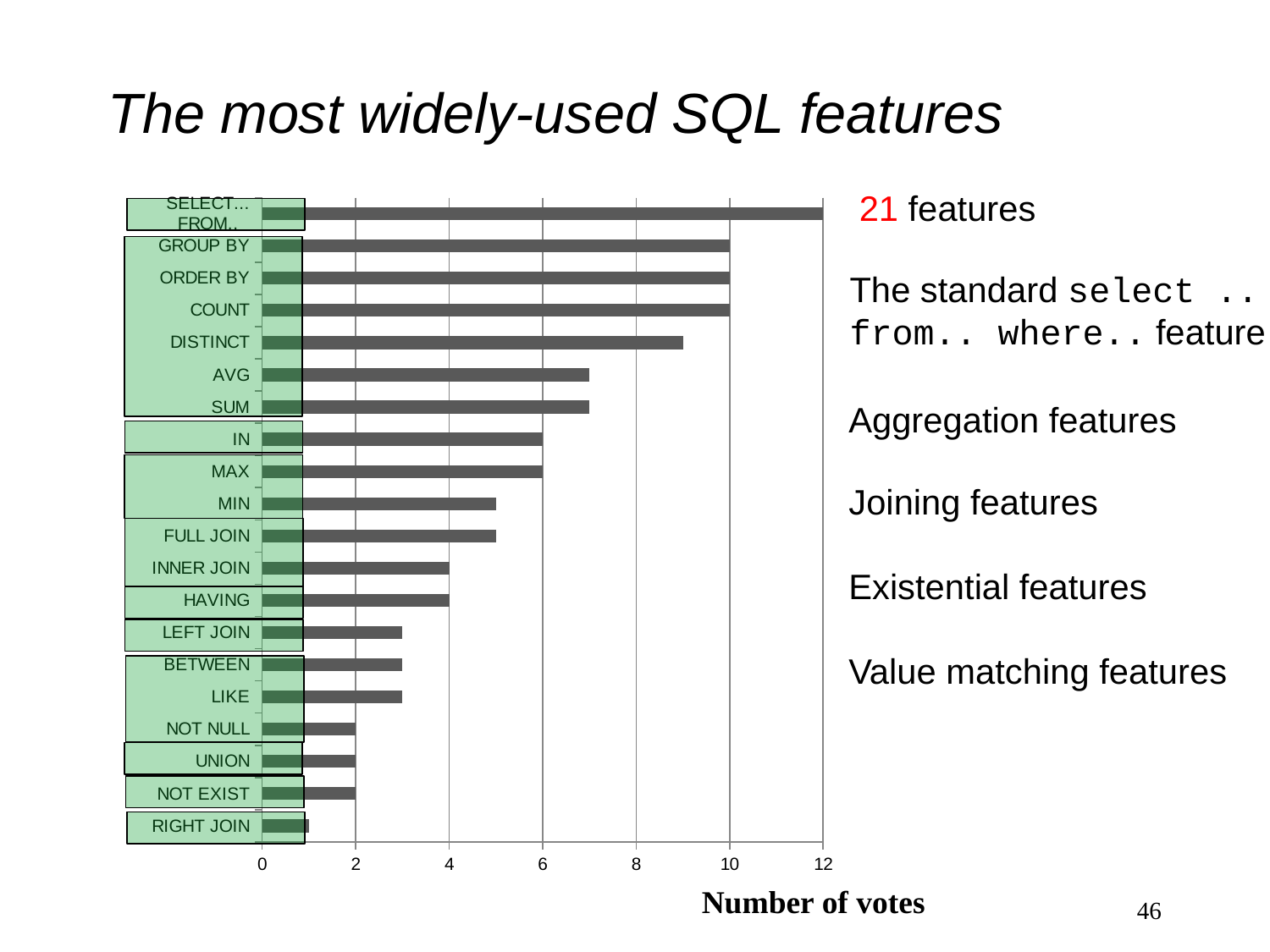
Is the number of votes for DISTINCT greater or less than 8? greater How many votes did SELECT... FROM.. receive? 12 What type of chart is shown on the slide? bar chart Is the number of votes for RIGHT JOIN greater or less than 2? less Which SQL feature received the fewest votes? RIGHT JOIN How many votes did INNER JOIN receive? 4 What is the difference in votes between SELECT... FROM.. and GROUP BY? 2 Which received more votes, IN or INNER JOIN? IN Which SQL feature received the most votes? SELECT... FROM.. What is the label of the horizontal axis? Number of votes How many votes did IN receive? 6 How many votes did GROUP BY receive? 10